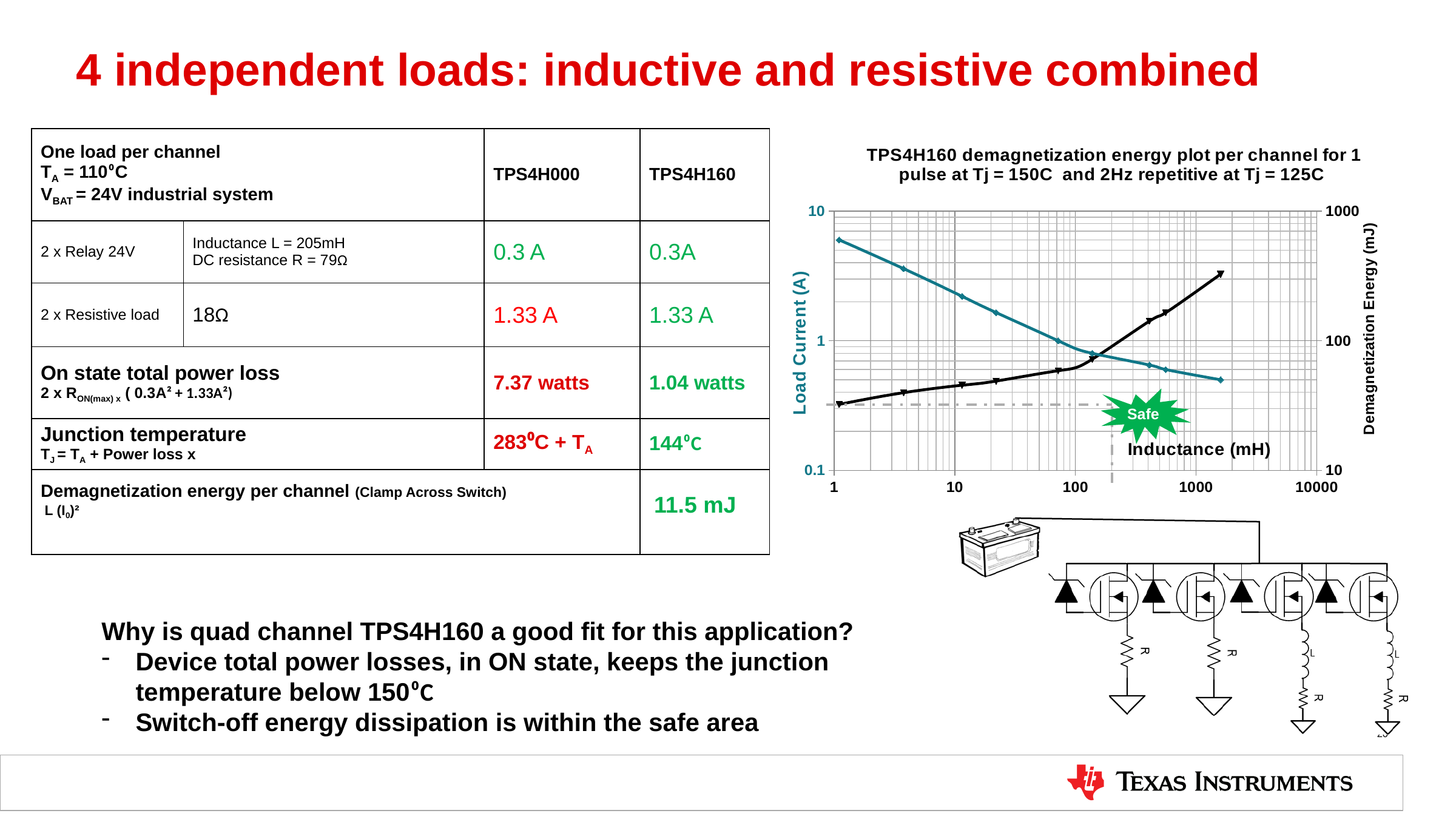
What is the label of the left vertical axis of the chart? Load Current (A) Is the demagnetization energy at an inductance of 100 mH greater or less than 100 mJ? less Is the demagnetization energy at an inductance of 1 mH greater or less than 100 mJ? less Which is larger: the load current at 1 mH or the load current at 1000 mH? load current at 1 mH Is the load current at an inductance of 1000 mH greater or less than 1 A? less What is the title of the chart? TPS4H160 demagnetization energy plot per channel for 1 pulse at Tj = 150C and 2Hz repetitive at Tj = 125C Does the Load Current line rise or fall as inductance increases along the x axis? fall What kind of chart is shown on the slide? line chart Does the Demagnetization Energy line rise or fall as inductance increases along the x axis? rise